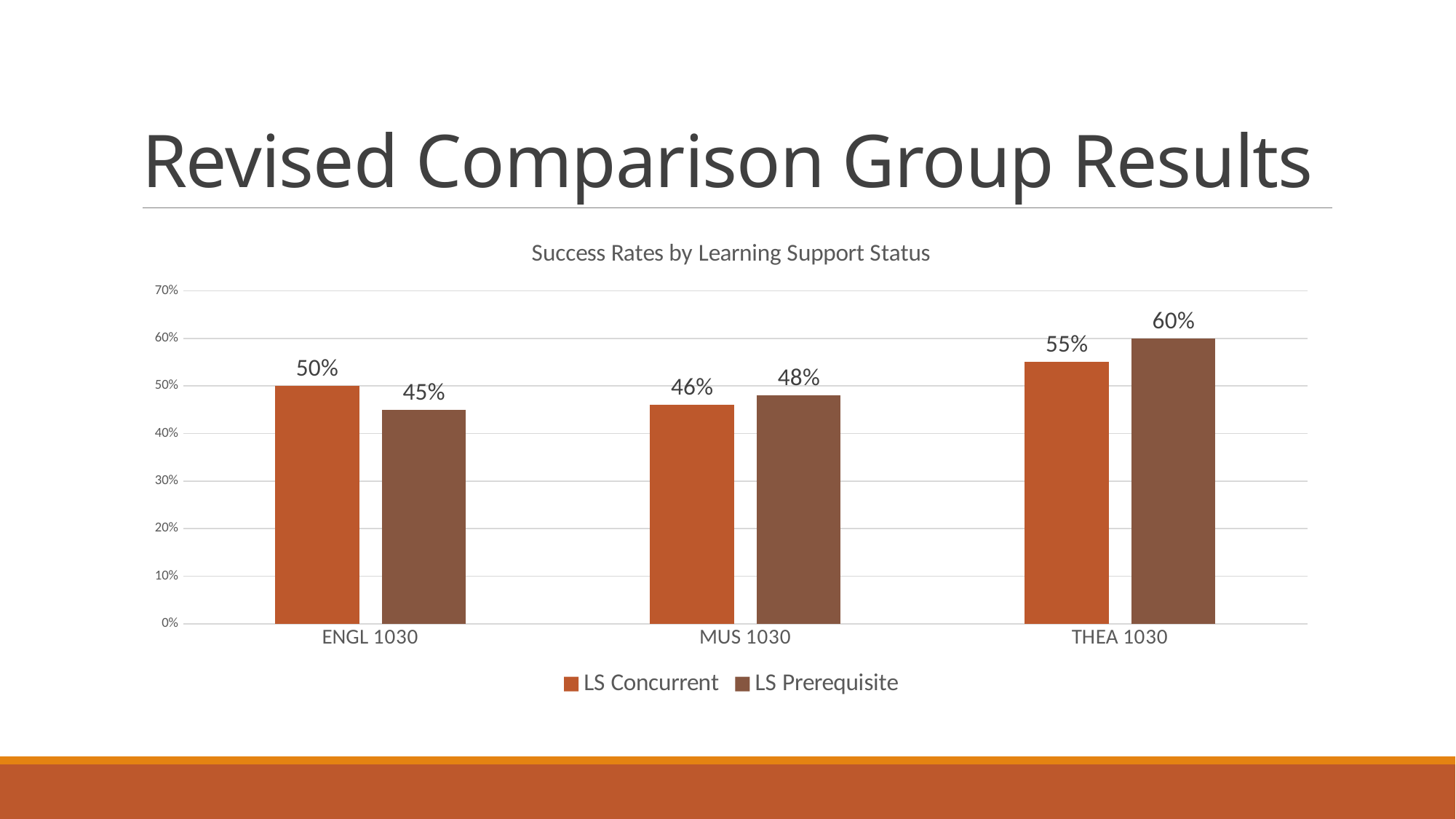
What is the LS Prerequisite success rate for MUS 1030? 48% Which course has the lowest LS Concurrent success rate? MUS 1030 What is the LS Concurrent success rate for ENGL 1030? 50% For ENGL 1030, which is larger: the LS Concurrent or the LS Prerequisite success rate? LS Concurrent How many series does the legend list? 2 What is the LS Prerequisite success rate for THEA 1030? 60% What is the difference between the LS Prerequisite and LS Concurrent success rates for THEA 1030? 5% What kind of chart is shown on the slide? Bar chart Which course has the highest LS Prerequisite success rate? THEA 1030 Is the LS Prerequisite success rate for ENGL 1030 greater or less than 50%? less How many courses are shown on the x axis? 3 What is the title of the chart? Success Rates by Learning Support Status